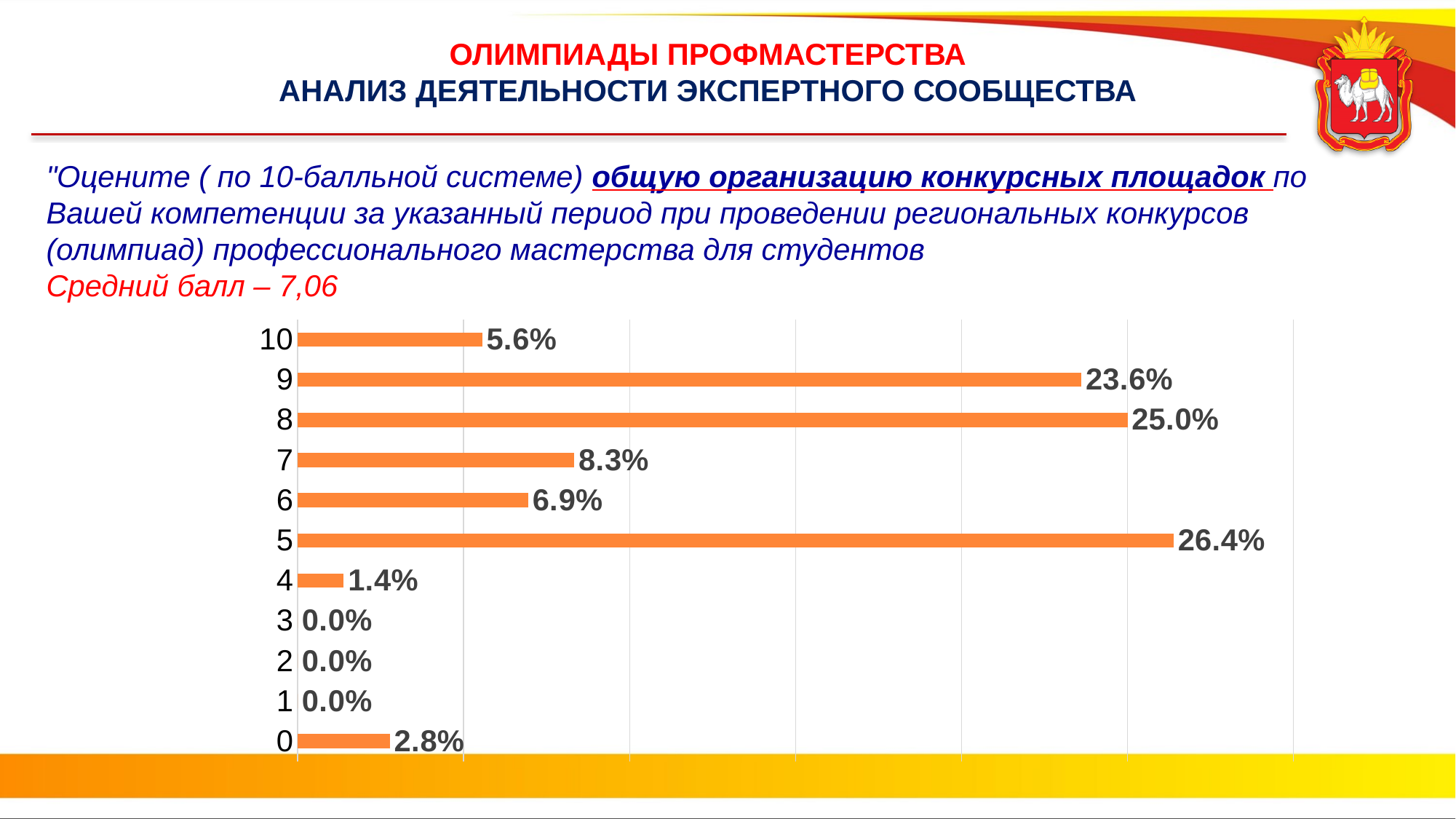
What percentage is shown for score 10? 5.6% How many score categories are shown in the chart? 11 What is the difference between the values for score 5 and score 8? 1.4% What percentage of respondents gave a score of 5? 26.4% What kind of chart is shown on the slide? bar chart What colour are the bars in the chart? orange What is the value for score 0? 2.8% Which score has the highest percentage? 5 What is the value shown for score 8? 25.0% What percentage is shown for score 4? 1.4% Which has a larger value, score 9 or score 8? 8 What is the lowest value shown in the chart? 0.0%